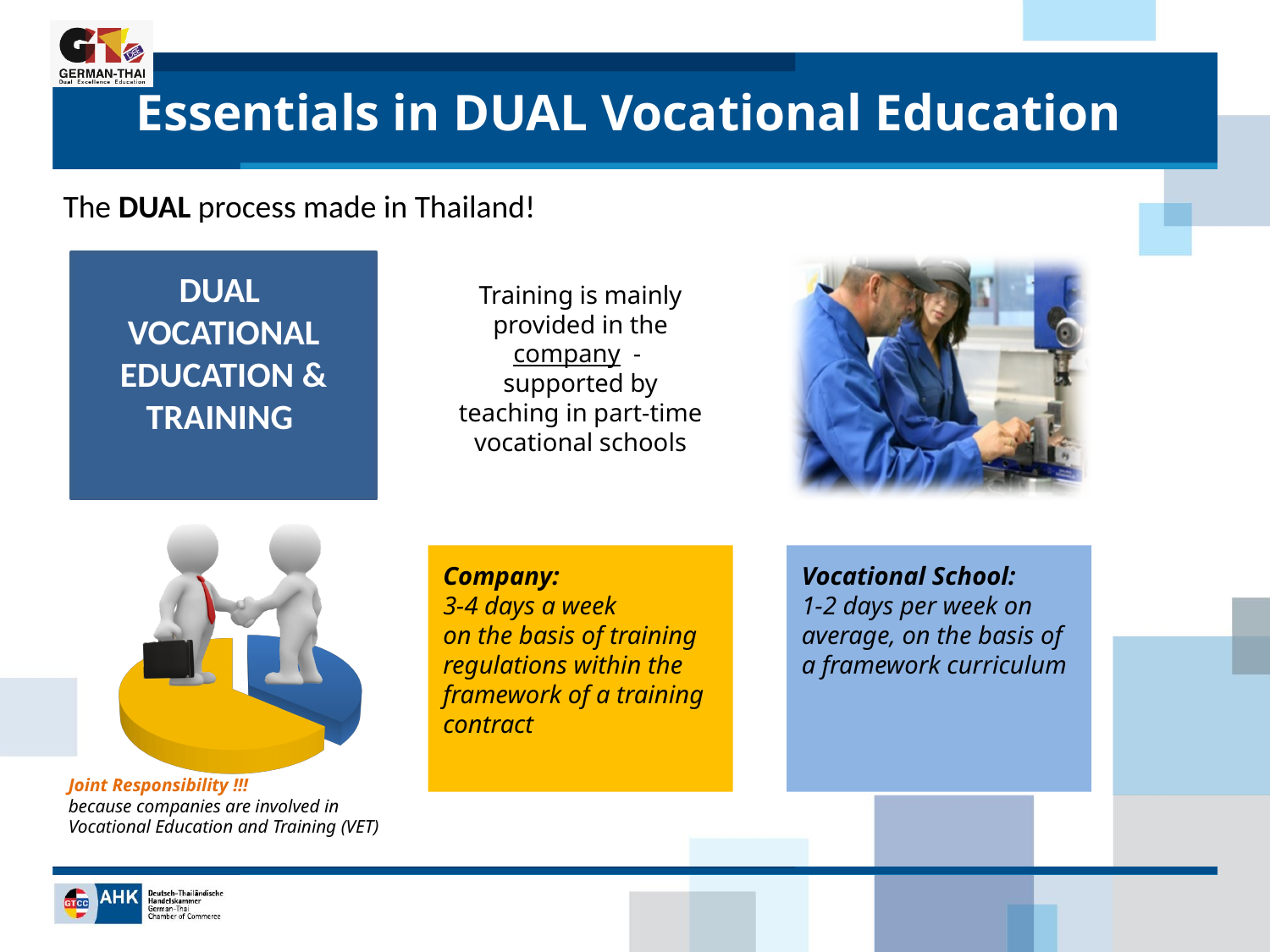
Which slice of the pie chart is larger, the yellow one or the blue one? the yellow one Which slice of the pie chart is the largest? the yellow slice Which slice of the pie chart is the smallest? the blue slice What kind of chart is shown on the lower left of the slide? pie chart What two colours are used for the slices of the pie chart? yellow and blue How many slices does the pie chart on the slide have? 2 Does the pie chart on the slide display a legend? No